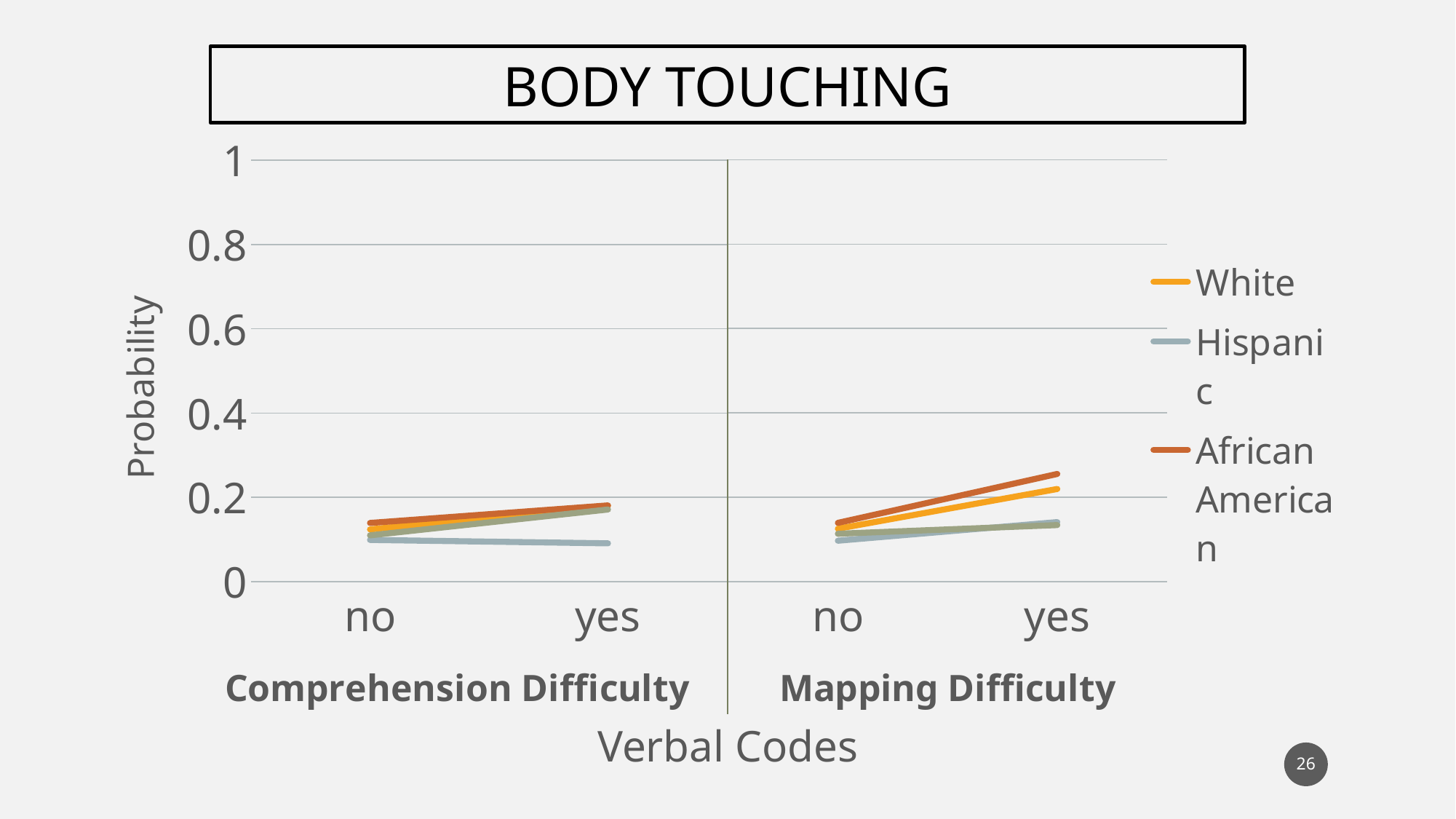
What is the label of the y axis? Probability Is the value for White at Mapping Difficulty 'yes' greater or less than 0.4? less Does the African American line rise or fall from 'no' to 'yes' under Mapping Difficulty? rise Is the value for African American at Mapping Difficulty 'yes' greater or less than 0.2? greater How many x-axis points are plotted in the chart? 4 Which series has the highest value at Mapping Difficulty 'yes'? African American At Comprehension Difficulty 'yes', which is larger: the value for White or the value for Hispanic? White Which series are listed in the legend? White, Hispanic, African American How many series does the legend list? 3 What kind of chart is shown on the slide? line chart Is the value for Hispanic at Comprehension Difficulty 'yes' greater or less than 0.2? less